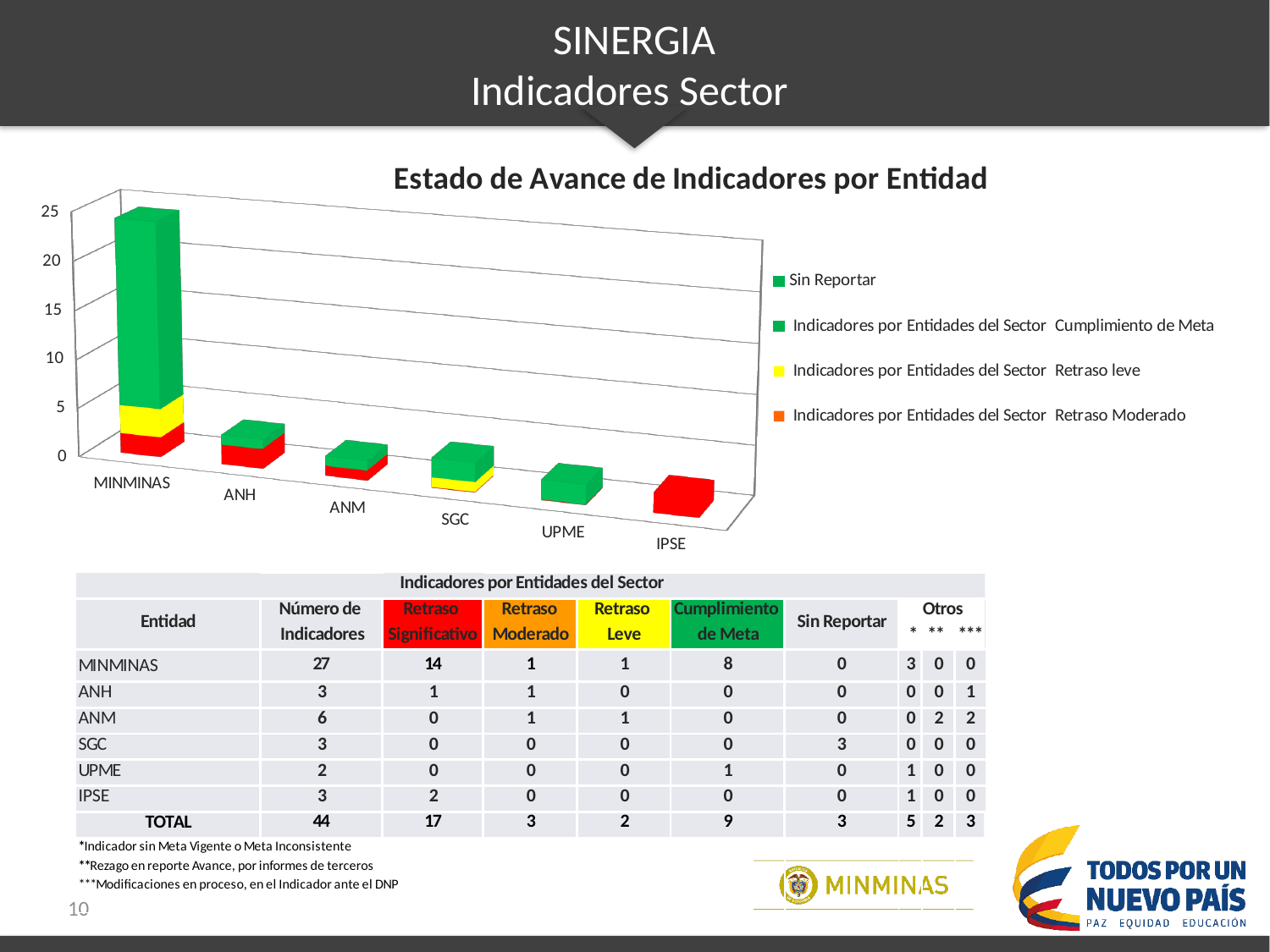
Which entity has the tallest bar in the chart? MINMINAS What is the highest value shown on the vertical axis of the chart? 25 Which bar is taller, IPSE or MINMINAS? MINMINAS How many series does the chart legend list? 4 Is the total height of the MINMINAS bar greater or less than 20? greater What is the title of the chart? Estado de Avance de Indicadores por Entidad Is the total height of the ANH bar greater or less than 5? less What kind of chart is shown on the slide? Bar chart What is the first entry listed in the chart legend? Sin Reportar How many entities (categories) are shown on the x axis of the chart? 6 Is the total height of the IPSE bar greater or less than 10? less Which bar is taller, MINMINAS or ANH? MINMINAS